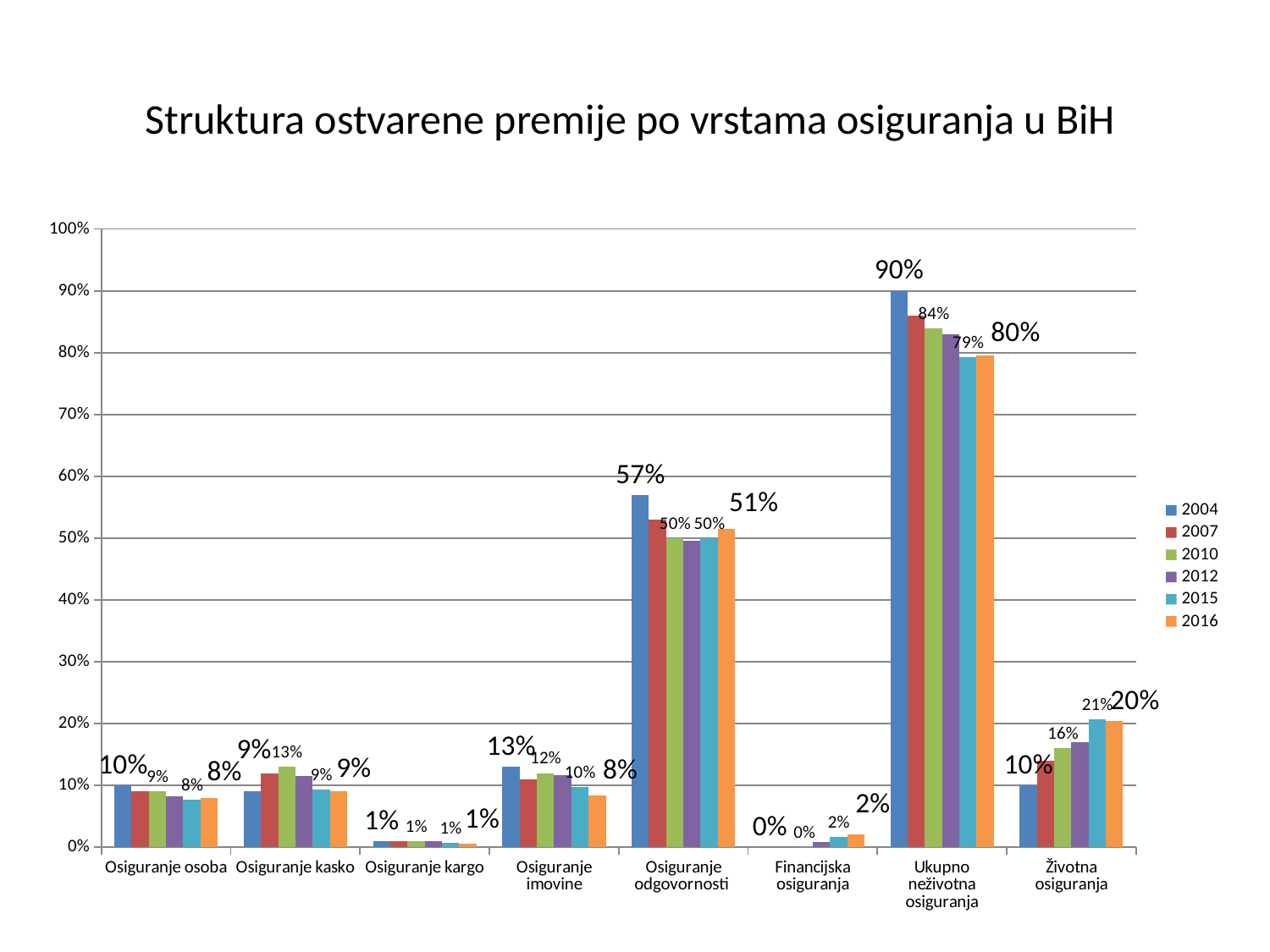
What is the 2004 value for Ukupno neživotna osiguranja? 90% What is the 2016 value for Životna osiguranja? 20% How many insurance categories are shown on the x axis? 8 What is the title of the chart? Struktura ostvarene premije po vrstama osiguranja u BiH What is the 2016 value for Ukupno neživotna osiguranja? 80% What kind of chart is shown on the slide? bar chart For Osiguranje imovine, which is larger: the 2004 value or the 2016 value? 2004 Which category has the highest value for 2004? Ukupno neživotna osiguranja What is the 2016 value for Financijska osiguranja? 2% What is the 2004 value for Osiguranje odgovornosti? 57% How many series does the legend list? 6 By how many percentage points did the value for Ukupno neživotna osiguranja fall from 2004 to 2016? 10 percentage points